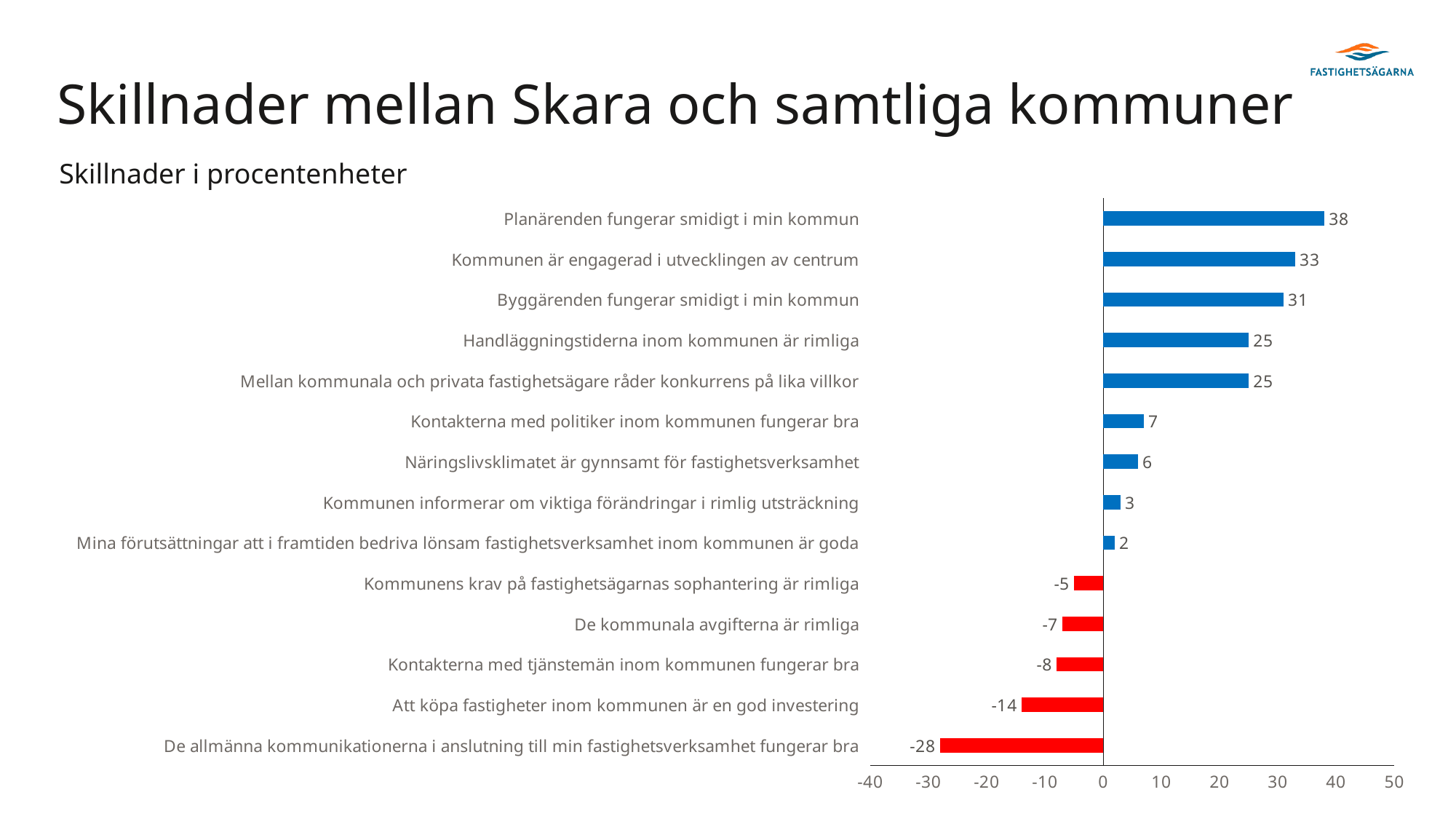
Which is larger, the value for "Näringslivsklimatet är gynnsamt för fastighetsverksamhet" or the value for "Kommunen informerar om viktiga förändringar i rimlig utsträckning"? Näringslivsklimatet är gynnsamt för fastighetsverksamhet Is the value for "Handläggningstiderna inom kommunen är rimliga" greater or less than 20? greater What is the value for "Kontakterna med politiker inom kommunen fungerar bra"? 7 What is the difference between the values for "Att köpa fastigheter inom kommunen är en god investering" and "De allmänna kommunikationerna i anslutning till min fastighetsverksamhet fungerar bra"? 14 What kind of chart is shown on the slide? bar chart What is the value for "Planärenden fungerar smidigt i min kommun"? 38 Which category has the lowest value? De allmänna kommunikationerna i anslutning till min fastighetsverksamhet fungerar bra How many categories are shown in the chart? 14 What is the difference between the values for "Kommunen är engagerad i utvecklingen av centrum" and "Byggärenden fungerar smidigt i min kommun"? 2 Which category has the highest value? Planärenden fungerar smidigt i min kommun What colour are the bars with negative values? red What is the value for "De kommunala avgifterna är rimliga"? -7